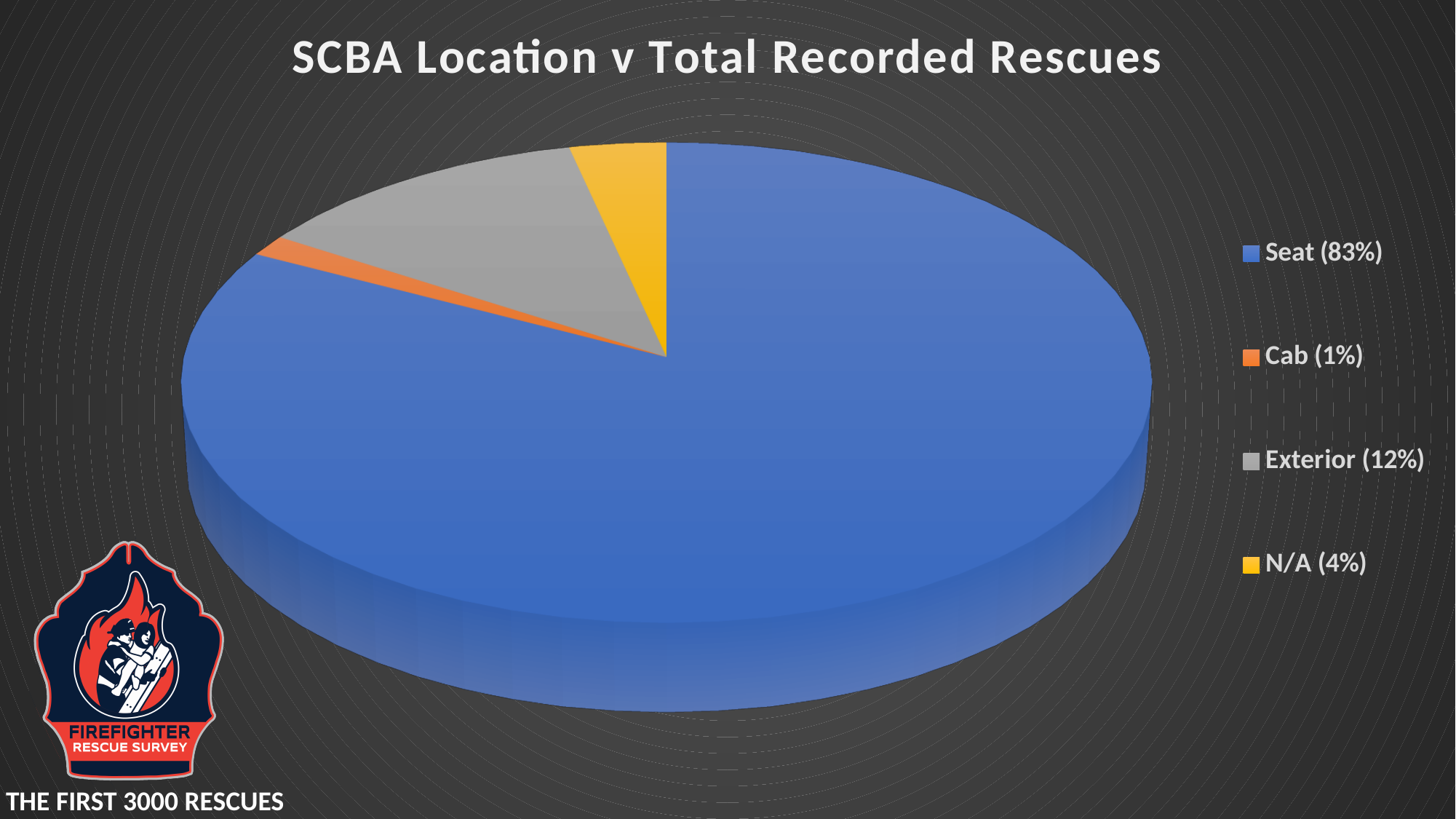
What share of the pie does N/A account for? 4% What is the title of the chart? SCBA Location v Total Recorded Rescues Which category has the largest share of the pie? Seat What share of the pie does Cab account for? 1% What share of the pie does Exterior account for? 12% How many categories does the pie chart show? 4 What colour is the Exterior slice in the pie chart? Grey Which category has the smallest share of the pie? Cab Which has a larger share, Exterior or N/A? Exterior What is the difference in percentage points between the Seat and Exterior shares? 71 What kind of chart is shown on the slide? Pie chart